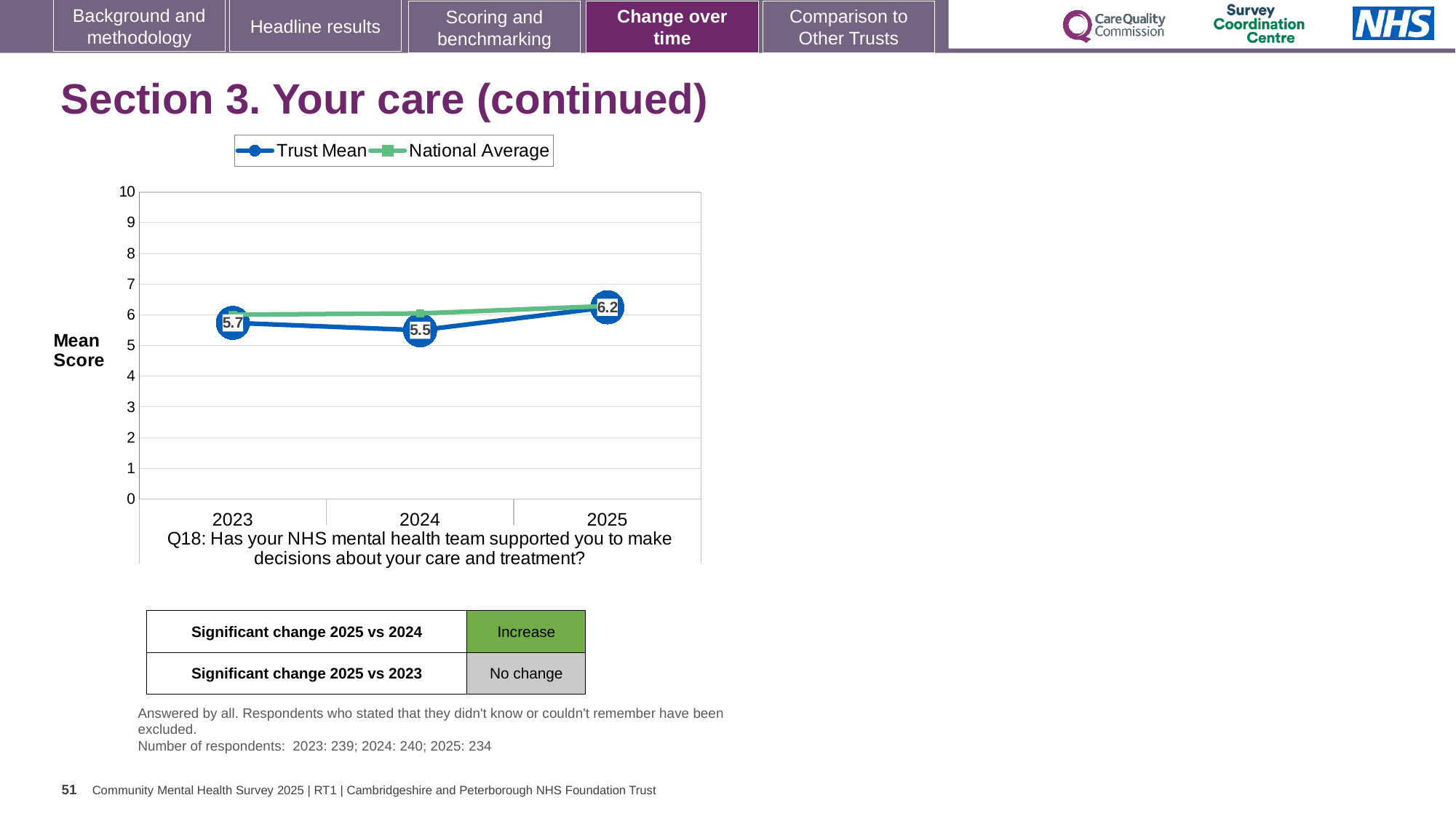
What is the Trust Mean score for 2024? 5.5 What is the Trust Mean score for 2023? 5.7 How many years are plotted on the x axis? 3 Which year has the larger Trust Mean score, 2023 or 2024? 2023 What kind of chart is shown on the slide? Line chart What is the Trust Mean score for 2025? 6.2 Is the National Average value for 2025 greater or less than 5? greater Does the Trust Mean score rise or fall from 2024 to 2025? Rise In which year is the Trust Mean score highest? 2025 By how much did the Trust Mean score change from 2024 to 2025? 0.7 In which year is the Trust Mean score lowest? 2024 How many series does the legend list? 2